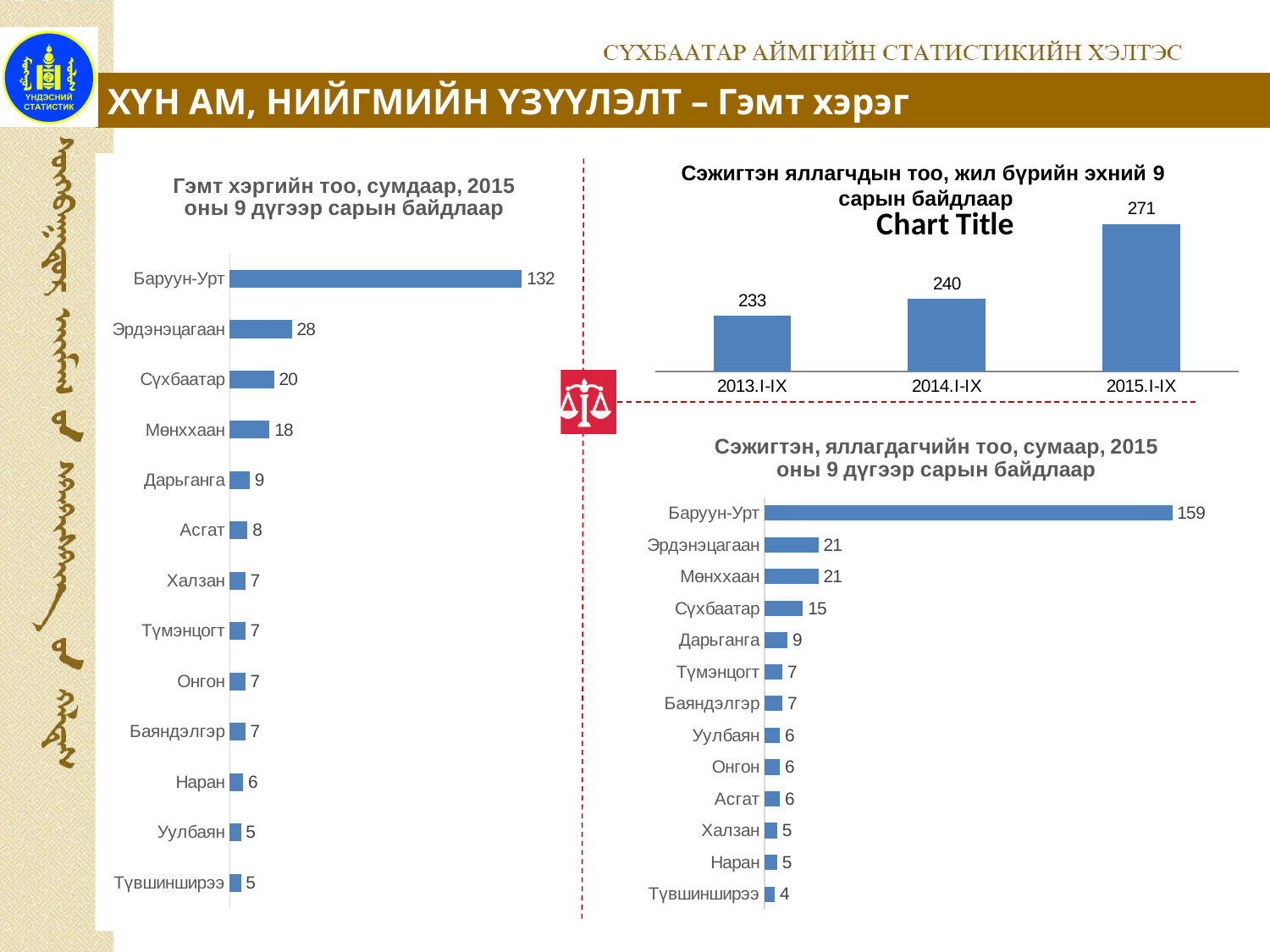
In the left chart (Гэмт хэргийн тоо, сумдаар), which category has the highest value? Баруун-Урт In the bottom right chart (Сэжигтэн, яллагдагчийн тоо, сумаар), what is the value for Баруун-Урт? 159 In the bottom right chart (Сэжигтэн, яллагдагчийн тоо, сумаар), which category has the lowest value? Түвшинширээ In the top right chart (Сэжигтэн яллагчдын тоо), do the values rise or fall from 2013.I-IX to 2015.I-IX? rise In the top right chart (Сэжигтэн яллагчдын тоо, жил бүрийн эхний 9 сарын байдлаар), what is the value for 2014.I-IX? 240 In the top right chart (Сэжигтэн яллагчдын тоо), what is the difference between 2015.I-IX and 2013.I-IX? 38 In the top right chart (Сэжигтэн яллагчдын тоо), which period has the lowest value? 2013.I-IX In the left chart (Гэмт хэргийн тоо, сумдаар), how many categories are shown? 13 In the left chart (Гэмт хэргийн тоо, сумдаар), what is the difference between Эрдэнэцагаан and Мөнххаан? 10 In the left chart (Гэмт хэргийн тоо, сумдаар), what is the value for Сүхбаатар? 20 In the bottom right chart (Сэжигтэн, яллагдагчийн тоо, сумаар), which is larger, Сүхбаатар or Дарьганга? Сүхбаатар In the left chart (Гэмт хэргийн тоо, сумдаар), what is the value for Баруун-Урт? 132